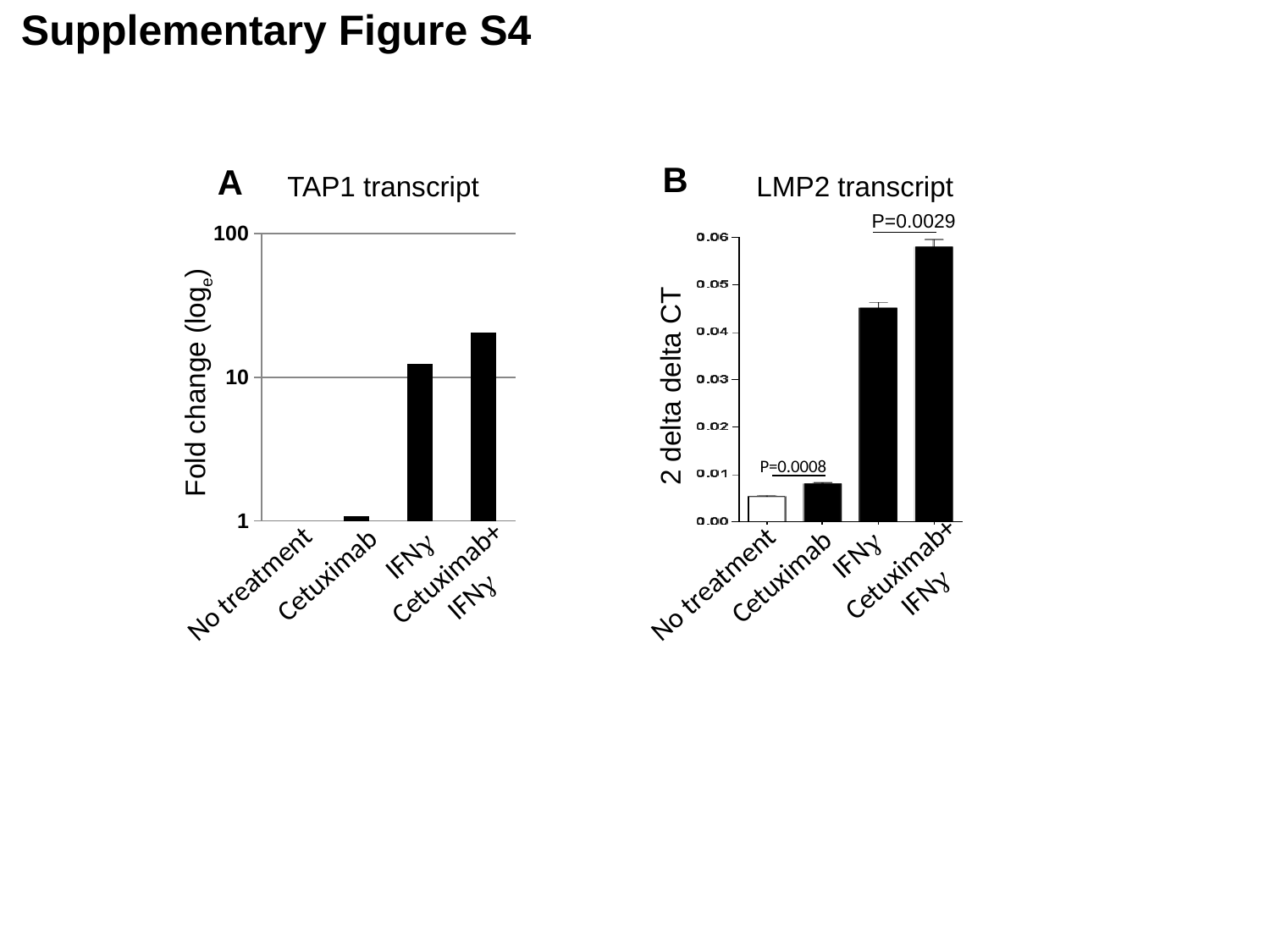
In the TAP1 transcript chart (panel A), is the value for IFNγ greater or less than 10? greater In the LMP2 transcript chart (panel B), is the value for Cetuximab greater or less than 0.01? less In the LMP2 transcript chart (panel B), is the value for IFNγ greater or less than 0.04? greater In the LMP2 transcript chart (panel B), what P value is shown between IFNγ and Cetuximab+IFNγ? P=0.0029 What is the y-axis label of the LMP2 transcript chart (panel B)? 2 delta delta CT How many categories are shown on the x axis of the LMP2 transcript chart (panel B)? 4 In the LMP2 transcript chart (panel B), which category has the highest value? Cetuximab+IFNγ In the TAP1 transcript chart (panel A), which category has the highest fold change? Cetuximab+IFNγ In the LMP2 transcript chart (panel B), which is larger: the value for IFNγ or the value for Cetuximab+IFNγ? Cetuximab+IFNγ What kind of chart is the TAP1 transcript chart (panel A)? bar chart